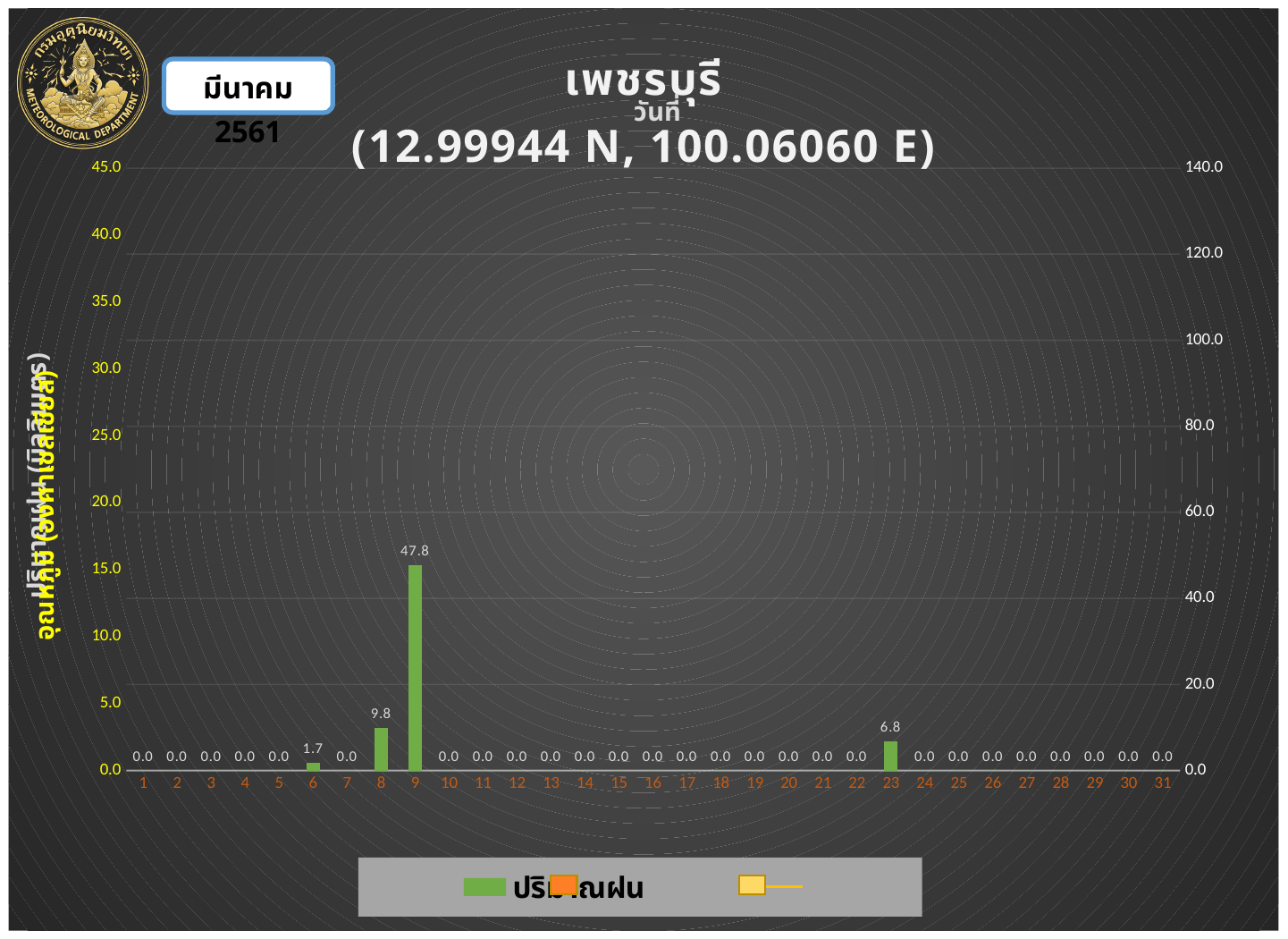
Which day has the highest rainfall value? 9 What coordinates are given in the chart title? 12.99944 N, 100.06060 E What is the rainfall value shown for day 8? 9.8 What is the rainfall value shown for day 15? 0.0 What is the rainfall value shown for day 9? 47.8 What is the difference between the rainfall values for day 8 and day 23? 3.0 What kind of chart is shown on the slide? bar chart What is the rainfall value shown for day 6? 1.7 What is the rainfall value shown for day 23? 6.8 What is the difference between the rainfall values for day 9 and day 8? 38.0 Which is larger, the rainfall value for day 23 or for day 6? day 23 How many days are shown on the x axis? 31